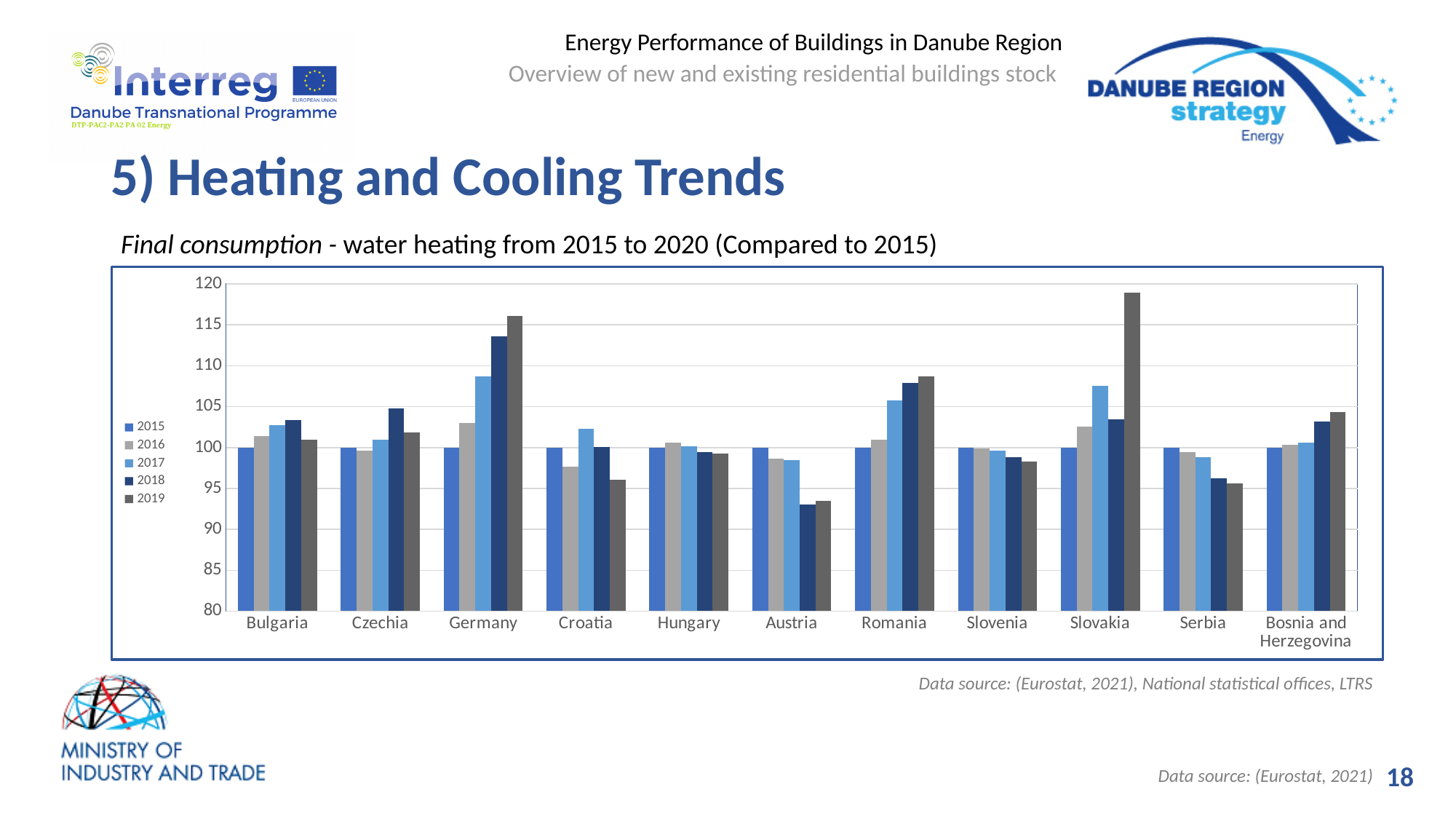
How many countries are shown on the x axis of the chart? 11 Is the 2018 value for Germany greater or less than 110? greater Do the values for Germany rise or fall from 2015 to 2019? rise What is the 2015 value for Hungary? 100 Which years are listed in the chart's legend? 2015, 2016, 2017, 2018, 2019 Which country has the highest 2019 value? Slovakia Which country has the lowest 2019 value? Austria Is the 2019 value for Slovakia greater or less than 115? greater How many series does the chart's legend list? 5 Which is larger, the 2019 value for Germany or the 2019 value for Romania? Germany What kind of chart is shown on the slide? bar chart Is the 2018 value for Austria greater or less than 95? less